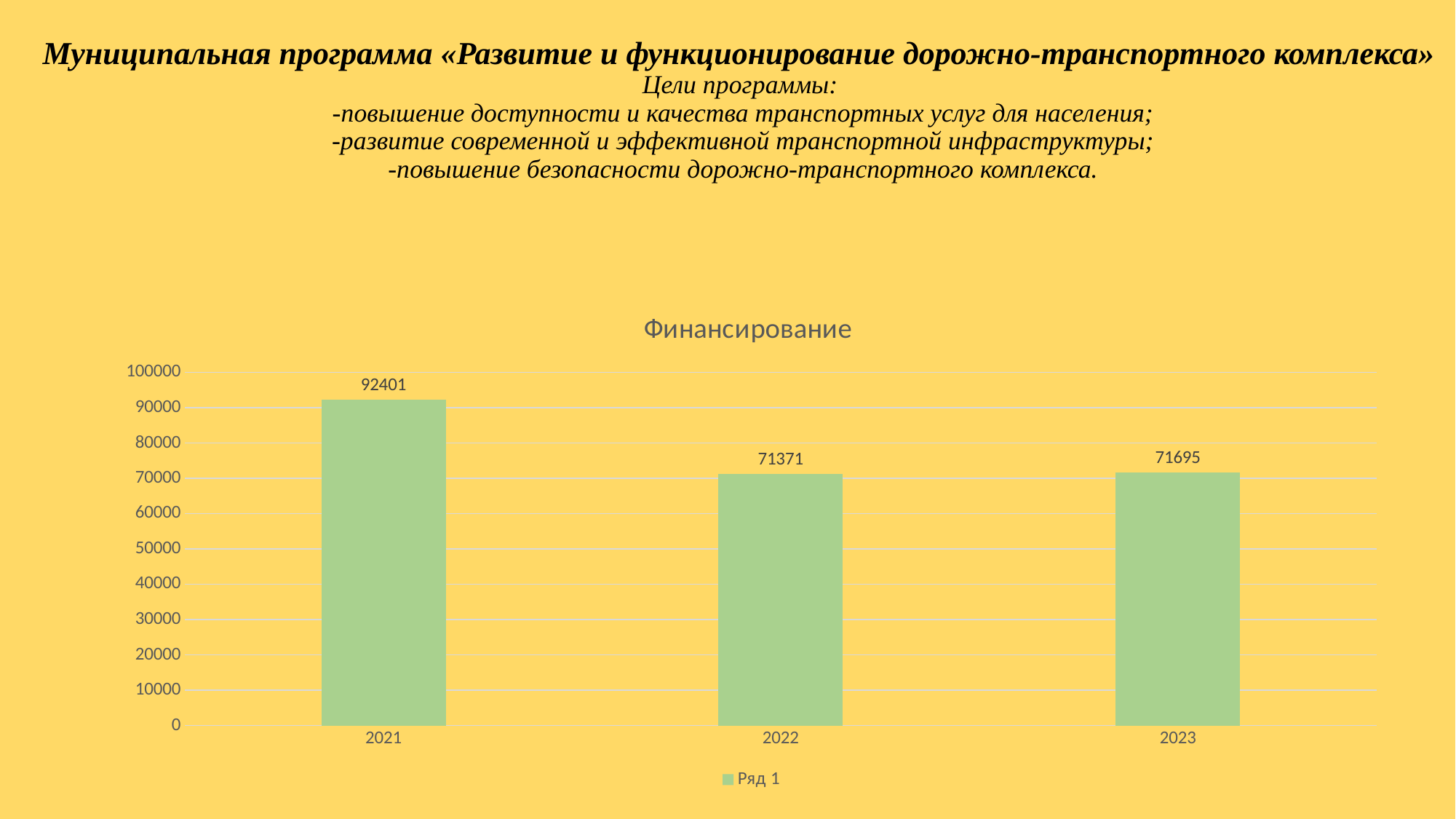
What is the difference between the values for 2021 and 2022 in the Финансирование chart? 21030 Which is larger in the Финансирование chart: the value for 2021 or the value for 2023? 2021 What kind of chart is the Финансирование chart? bar chart What is the value for 2021 in the Финансирование chart? 92401 What is the value for 2023 in the Финансирование chart? 71695 How many years are shown on the x axis of the Финансирование chart? 3 What is the difference between the values for 2023 and 2022 in the Финансирование chart? 324 What is the title of the chart on the slide? Финансирование Which year has the highest value in the Финансирование chart? 2021 What is the value for 2022 in the Финансирование chart? 71371 Is the value for 2022 in the Финансирование chart greater or less than 80000? less Which year has the lowest value in the Финансирование chart? 2022